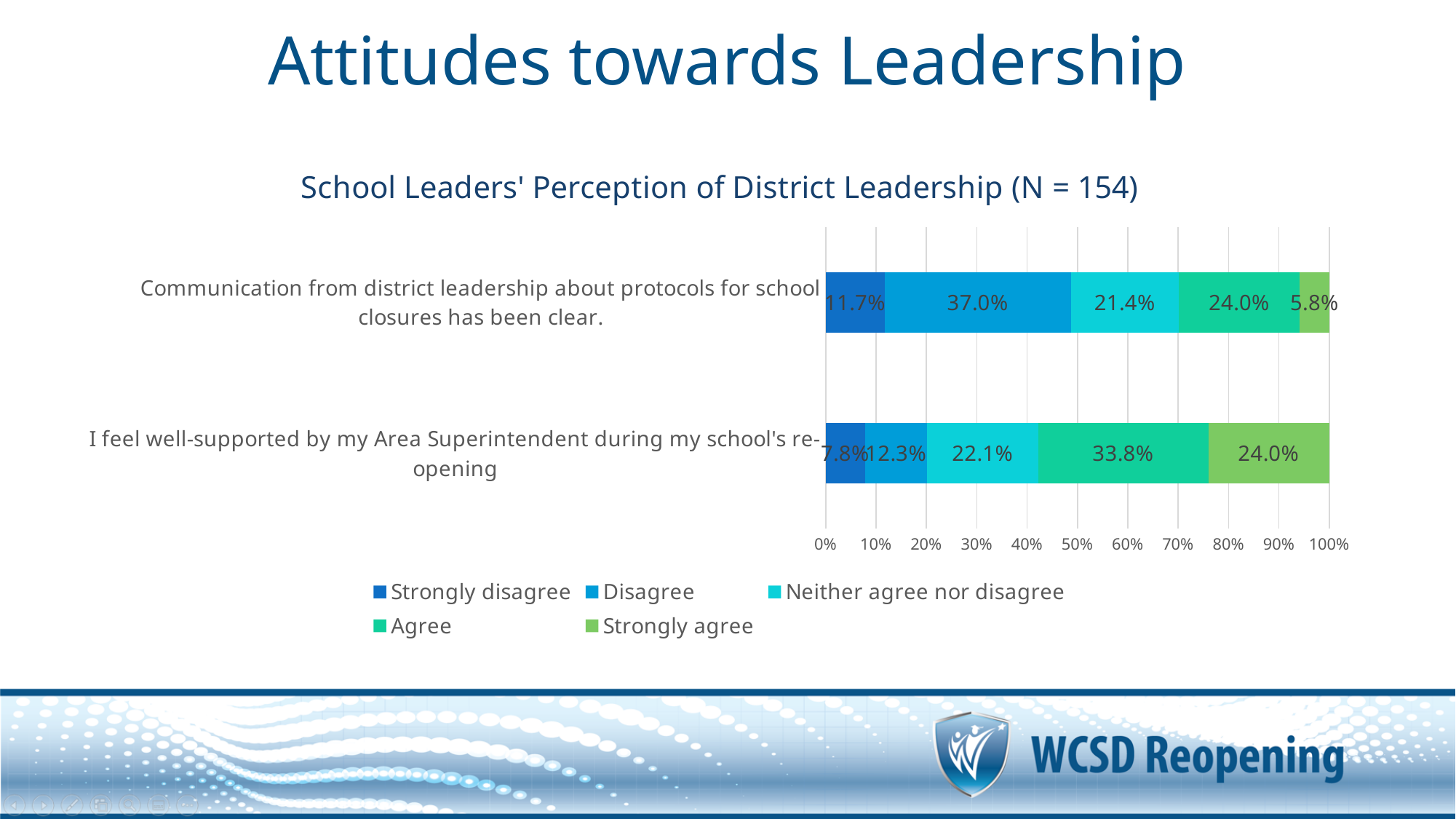
What is the difference between the Disagree share for the communication statement and the Disagree share for the Area Superintendent statement? 24.7% What percentage of school leaders disagree that communication from district leadership about protocols for school closures has been clear? 37.0% Which statement has a larger Strongly agree share: the one about communication from district leadership or the one about feeling well-supported by the Area Superintendent? I feel well-supported by my Area Superintendent during my school's re-opening What percentage of school leaders strongly disagree that they feel well-supported by their Area Superintendent during their school's re-opening? 7.8% What is the sample size (N) given in the chart title? 154 What percentage of school leaders agree that they feel well-supported by their Area Superintendent during their school's re-opening? 33.8% What type of chart is shown on the slide? Stacked bar chart Which response category has the smallest share for the statement about feeling well-supported by the Area Superintendent? Strongly disagree How many statements (bars) are shown in the chart? 2 Which response category has the largest share for the statement about communication from district leadership about protocols for school closures? Disagree How many response categories does the legend list? 5 What percentage of school leaders strongly agree that communication from district leadership about protocols for school closures has been clear? 5.8%